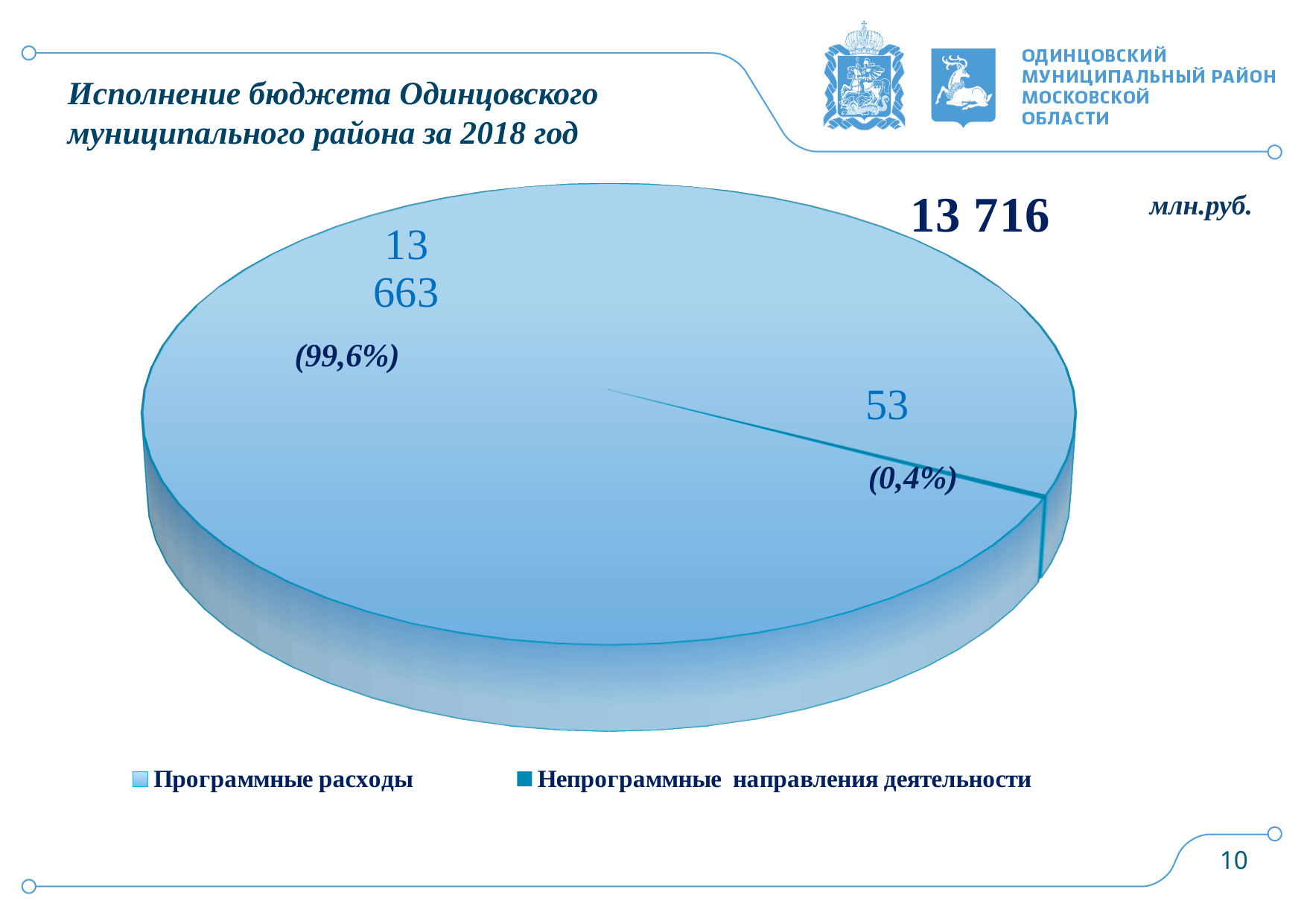
Which category has the smallest slice of the pie? Непрограммные направления деятельности How many categories does the legend list? 2 What share of the pie does Программные расходы take? 99,6% In what units are the values on the chart given? млн.руб. What kind of chart is shown on the slide? pie chart What total value is printed above the pie chart? 13 716 Which category has the largest slice of the pie? Программные расходы What is the value for Программные расходы? 13 663 What is the difference between the values for Программные расходы and Непрограммные направления деятельности? 13 610 What is the value for Непрограммные направления деятельности? 53 What share of the pie does Непрограммные направления деятельности take? 0,4% Which is larger: Программные расходы or Непрограммные направления деятельности? Программные расходы